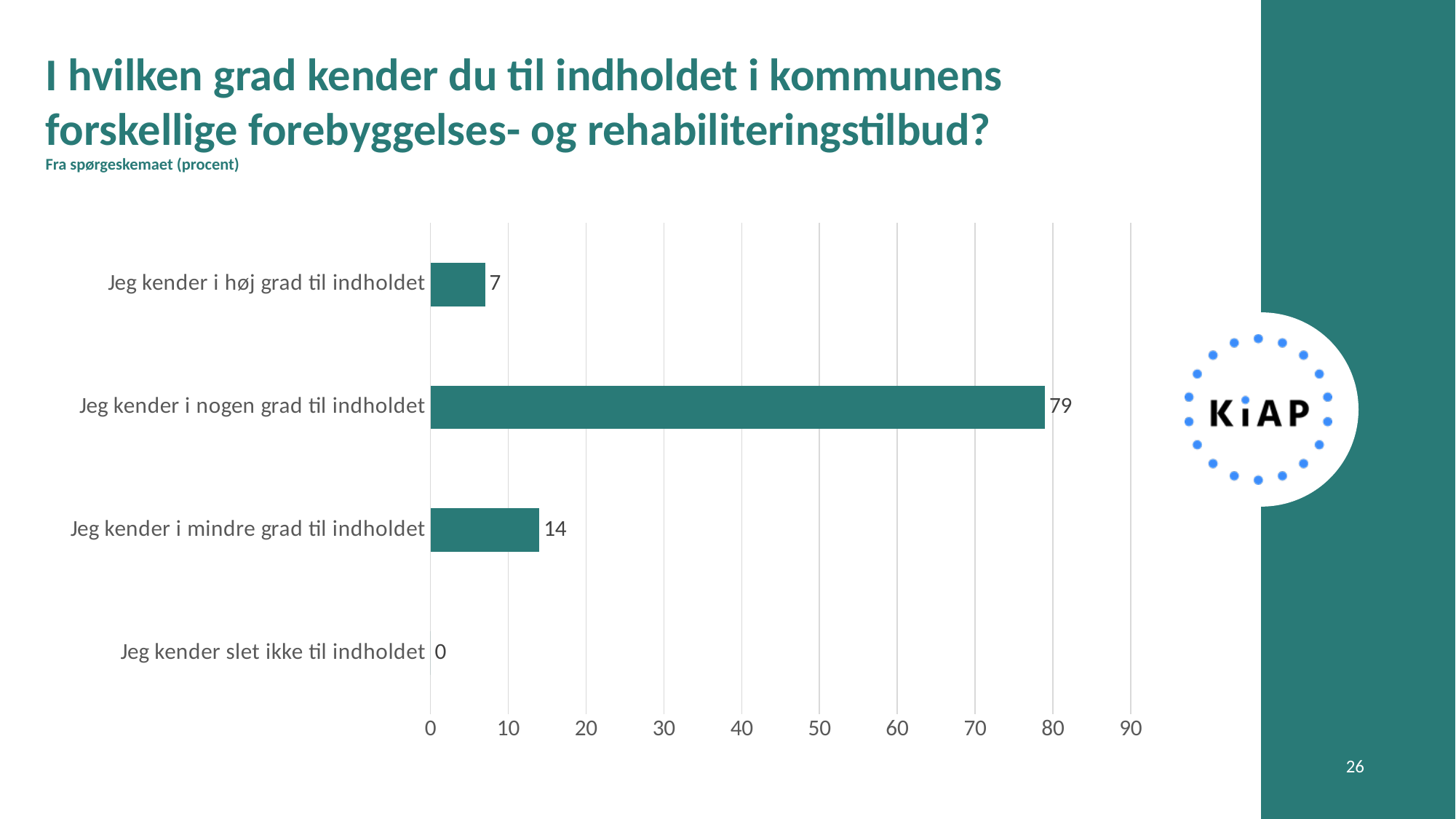
Which category has the lowest value? Jeg kender slet ikke til indholdet Is the value for "Jeg kender i nogen grad til indholdet" greater or less than 70? greater What is the value for "Jeg kender slet ikke til indholdet"? 0 What is the value for "Jeg kender i nogen grad til indholdet"? 79 Which category has the highest value? Jeg kender i nogen grad til indholdet How many categories are shown in the chart? 4 What is the difference between the values for "Jeg kender i nogen grad til indholdet" and "Jeg kender i mindre grad til indholdet"? 65 What kind of chart is shown on the slide? bar chart What is the highest value shown on the x axis? 90 What is the value for "Jeg kender i mindre grad til indholdet"? 14 Which is larger: the value for "Jeg kender i mindre grad til indholdet" or "Jeg kender i høj grad til indholdet"? Jeg kender i mindre grad til indholdet What is the value for "Jeg kender i høj grad til indholdet"? 7